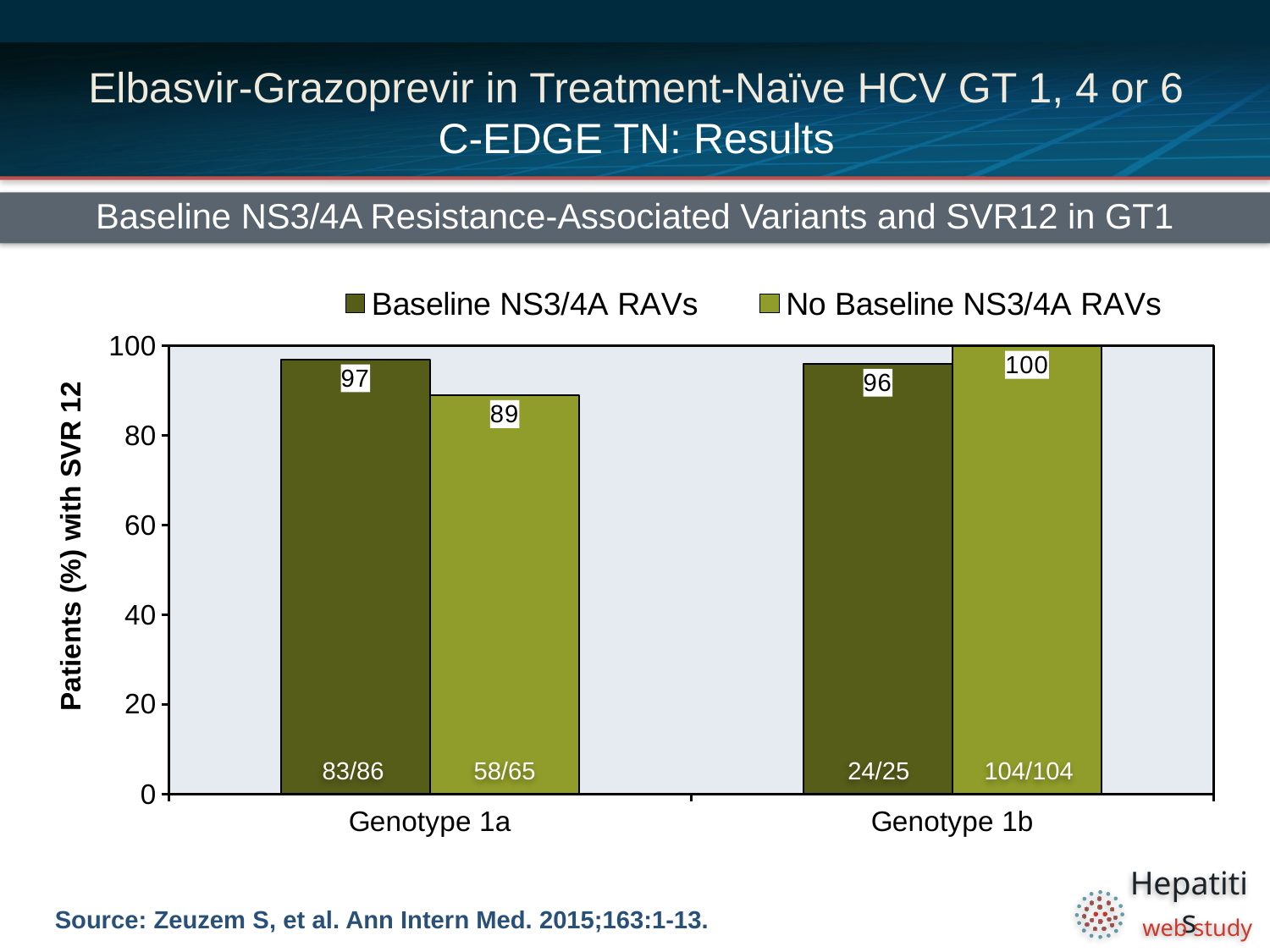
What type of chart is shown on the slide? Bar chart Which bar has the lowest SVR12 rate? Genotype 1a, No Baseline NS3/4A RAVs What fraction of patients is shown inside the Baseline NS3/4A RAVs bar for Genotype 1a? 83/86 What is the SVR12 rate for Genotype 1a patients with Baseline NS3/4A RAVs? 97 What fraction of patients is shown inside the No Baseline NS3/4A RAVs bar for Genotype 1b? 104/104 How many series does the legend list? 2 Which bar has the highest SVR12 rate? Genotype 1b, No Baseline NS3/4A RAVs What is the SVR12 rate for Genotype 1b patients with No Baseline NS3/4A RAVs? 100 What is the SVR12 rate for Genotype 1b patients with Baseline NS3/4A RAVs? 96 For Genotype 1b, which group has the higher SVR12 rate: Baseline NS3/4A RAVs or No Baseline NS3/4A RAVs? No Baseline NS3/4A RAVs What is the difference in SVR12 rate between the Baseline NS3/4A RAVs and No Baseline NS3/4A RAVs bars for Genotype 1a? 8 What is the SVR12 rate for Genotype 1a patients with No Baseline NS3/4A RAVs? 89